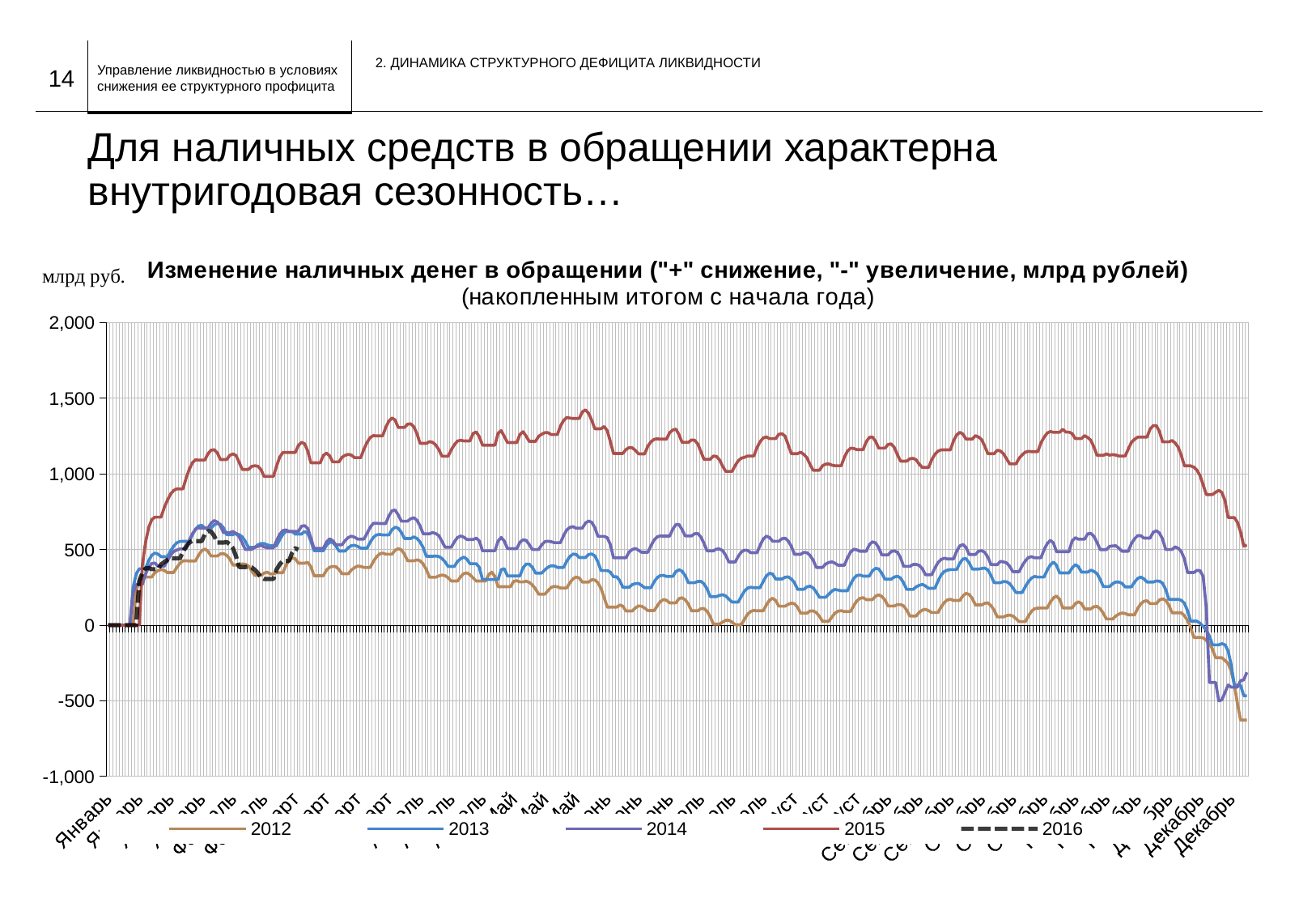
Is the value of the 2012 series at the end of December greater or less than -500? less Is the peak value of the 2015 series greater or less than 1,000? greater Which years are listed in the chart legend? 2012, 2013, 2014, 2015, 2016 How many series does the legend list? 5 What is the unit shown on the vertical axis label? млрд руб. What kind of chart is shown on the slide? line chart Which series has the higher values in the middle of the year, 2015 or 2012? 2015 Which series reaches the highest values on the chart? 2015 Do the values of the 2013 series rise or fall during January? rise Is the peak value of the 2014 series greater or less than 1,000? less Do the values of the 2015 series rise or fall over December? fall Which series is drawn with a dashed line? 2016